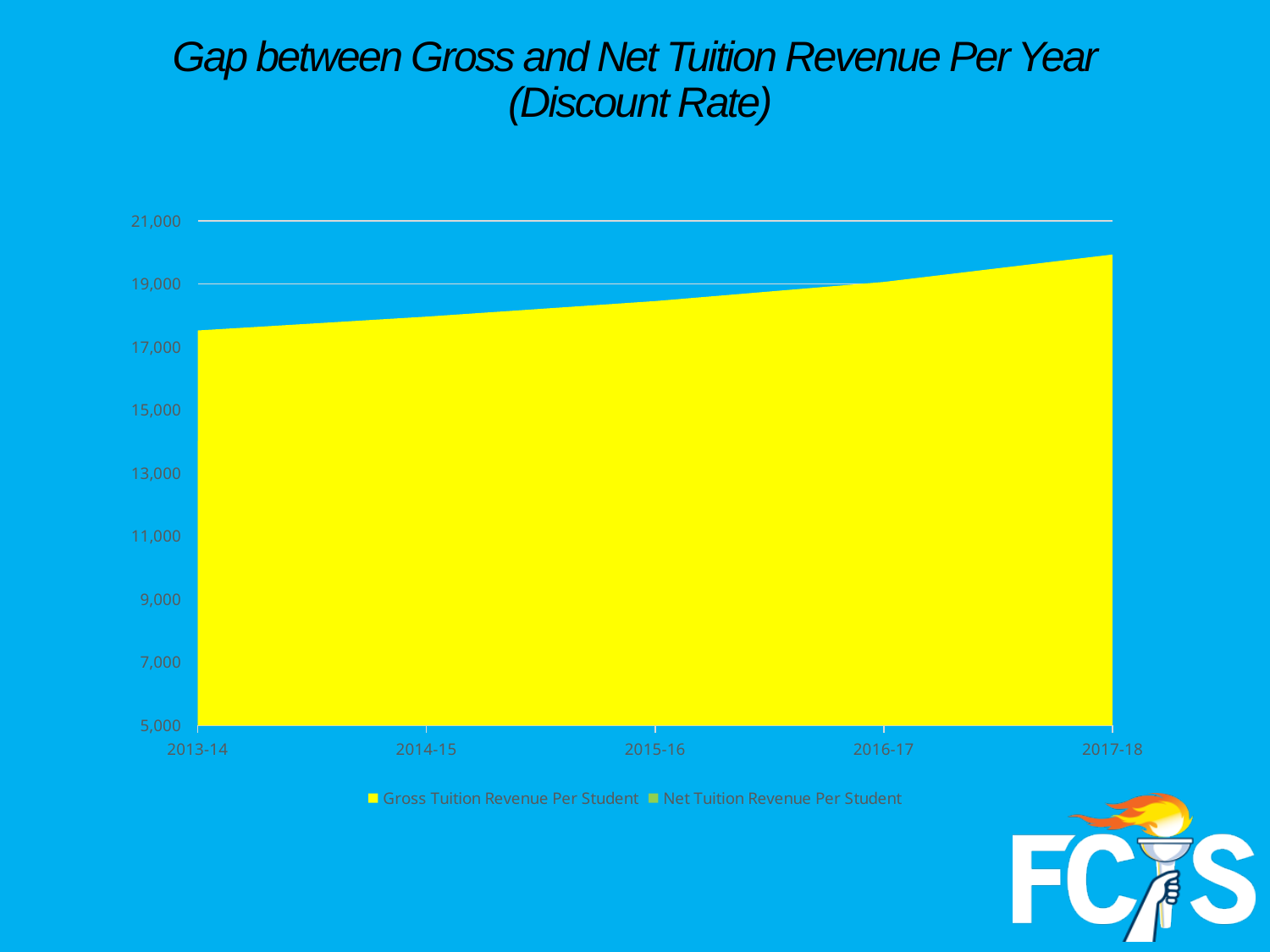
How many series does the legend list? 2 Is the plotted value for 2015-16 greater or less than 19,000? less How many academic years are shown on the x axis? 5 Which year has the highest plotted value? 2017-18 Is the plotted value for 2017-18 greater or less than 19,000? greater What kind of chart is shown on the slide? Area chart Is the plotted value for 2014-15 greater or less than 17,000? greater Do the plotted values rise or fall from 2013-14 to 2017-18? Rise What is the title of the chart? Gap between Gross and Net Tuition Revenue Per Year (Discount Rate) Which is larger, the plotted value for 2017-18 or for 2013-14? 2017-18 Which year has the lowest plotted value? 2013-14